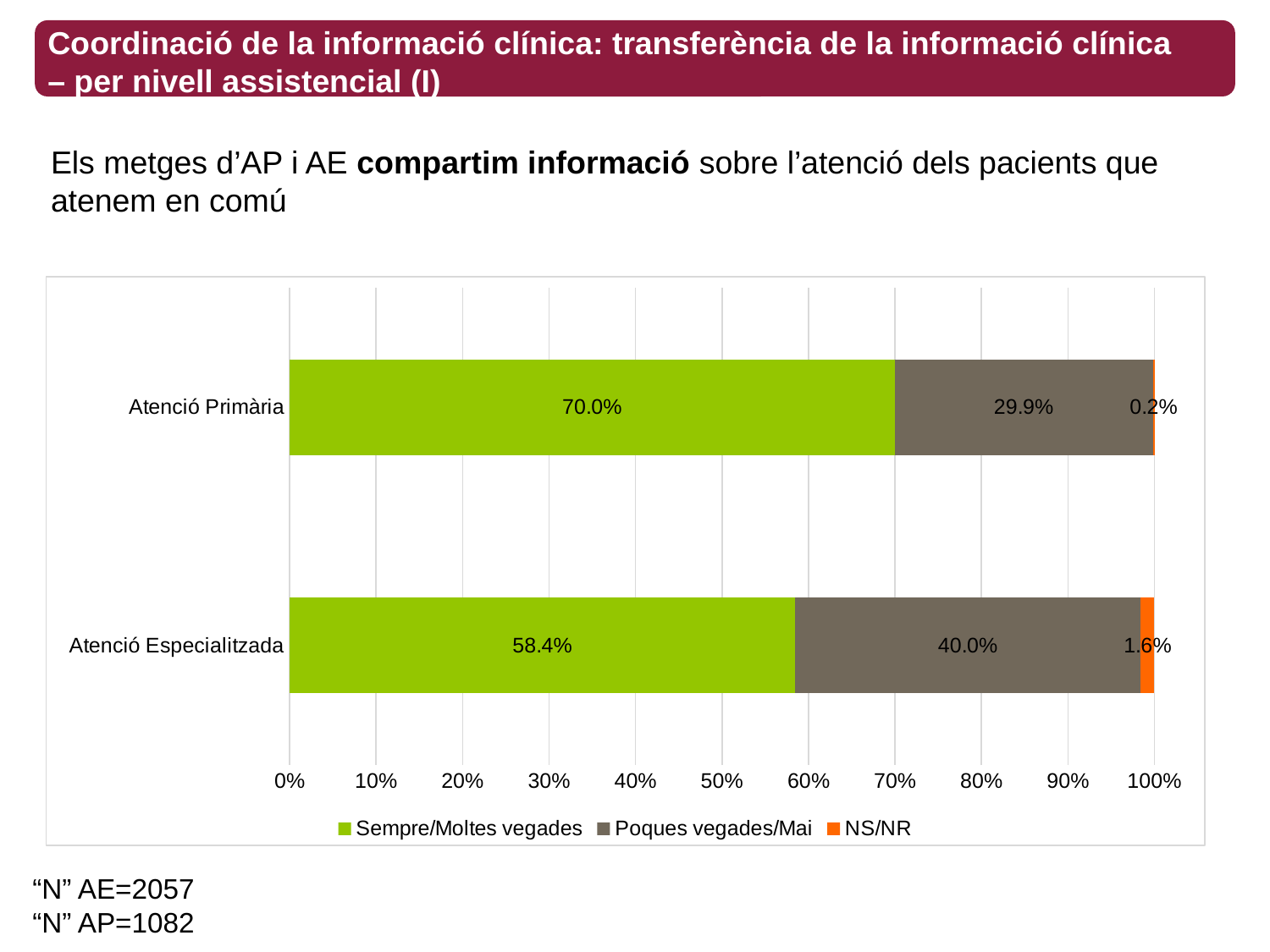
What is the NS/NR value for Atenció Especialitzada? 1.6% Is the Poques vegades/Mai value larger for Atenció Primària or Atenció Especialitzada? Atenció Especialitzada What is the value for Poques vegades/Mai for Atenció Especialitzada? 40.0% What is the value for Sempre/Moltes vegades for Atenció Primària? 70.0% Which category has the lower value for Poques vegades/Mai? Atenció Primària Which colour represents the NS/NR series? Orange Which category has the higher value for Sempre/Moltes vegades? Atenció Primària What is the difference between the Sempre/Moltes vegades values for Atenció Primària and Atenció Especialitzada? 11.6% How many series does the legend list? 3 What kind of chart is shown? Stacked bar chart How many categories are shown on the chart? 2 What is the NS/NR value for Atenció Primària? 0.2%